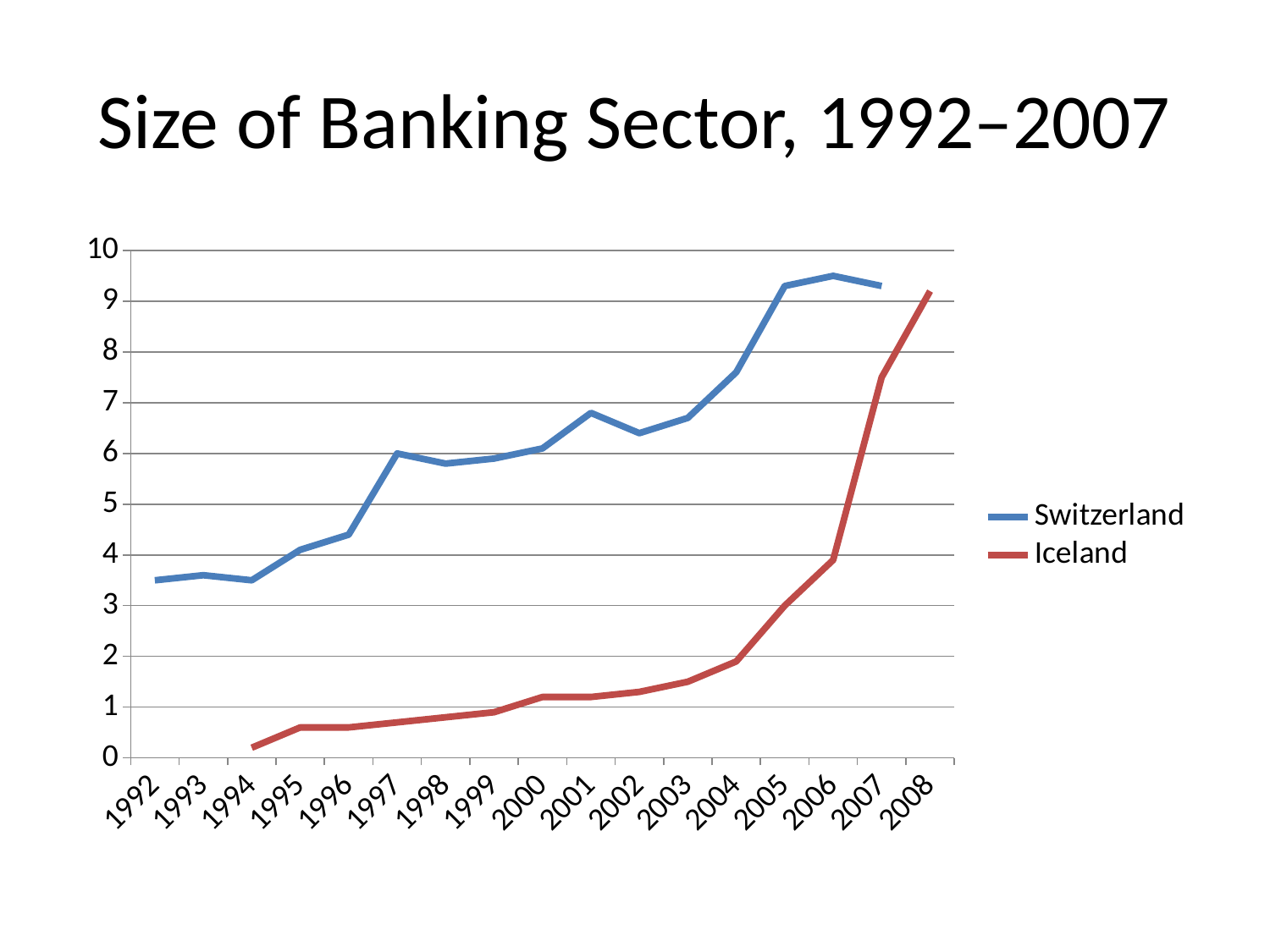
What kind of chart is shown on the slide? line chart How many years are labelled on the x axis? 17 Does the Iceland line generally rise or fall from 1994 to 2008? rise Is the value for Iceland in 2007 greater or less than 7? greater How many series does the legend list? 2 Is the value for Switzerland in 1992 greater or less than 3? greater Is the value for Iceland in 2004 greater or less than 3? less In which year does the Iceland line have its lowest value? 1994 Which series has the larger value in 2000, Switzerland or Iceland? Switzerland In which year does the Switzerland line reach its highest value? 2006